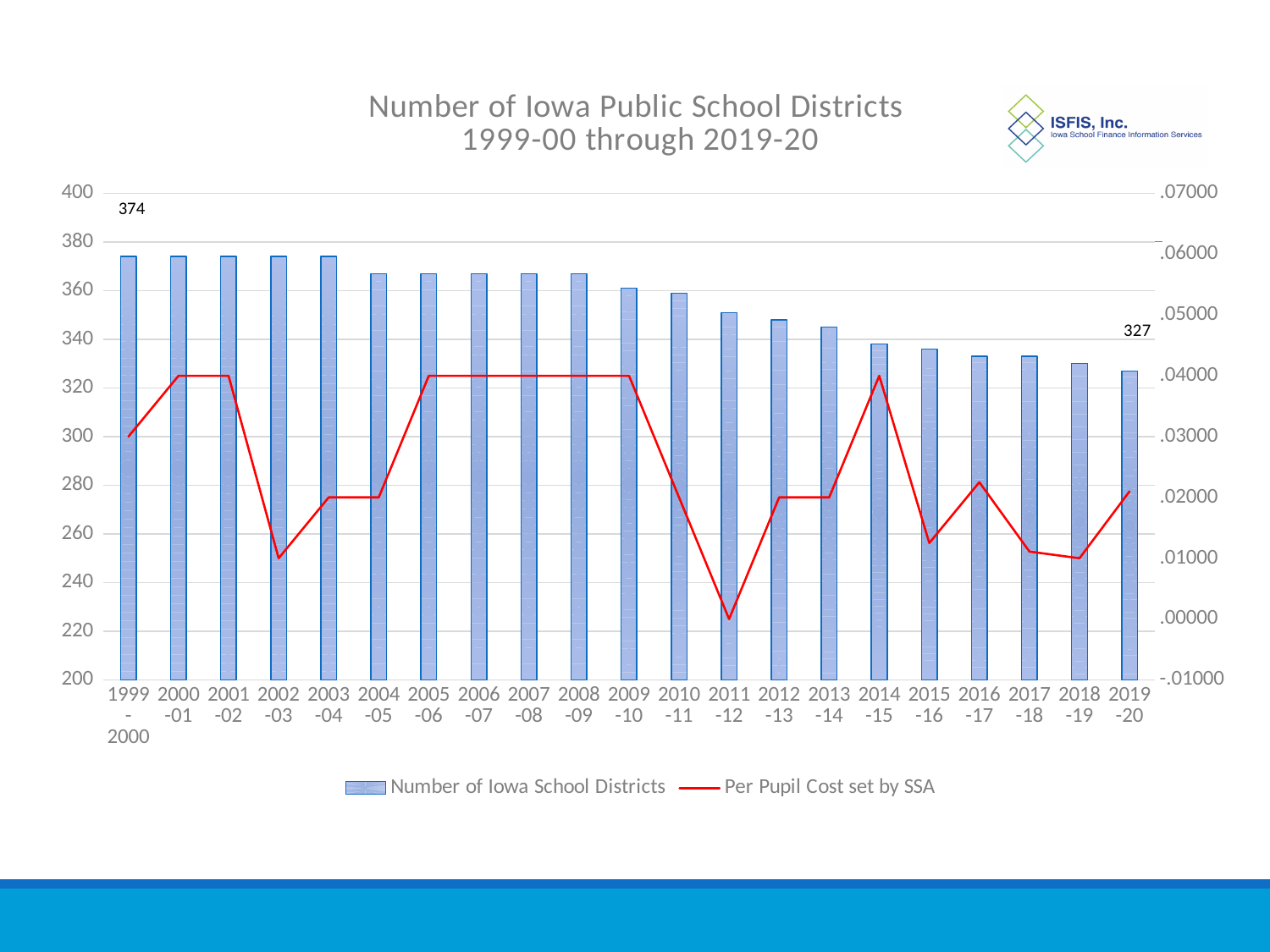
What series does the red line represent? Per Pupil Cost set by SSA What kind of chart is this? bar chart with a line In which school year is the Per Pupil Cost set by SSA line at its lowest point? 2011-12 Is the number of Iowa school districts for 2011-12 greater or less than 340? greater Do the bars for the number of Iowa school districts rise or fall from 1999-2000 to 2019-20? fall How many series does the legend list? 2 Which has more Iowa school districts, 2009-10 or 2013-14? 2009-10 What is the number of Iowa school districts shown for 1999-2000? 374 What is the number of Iowa school districts shown for 2019-20? 327 How many school years are shown along the x axis? 21 Is the number of Iowa school districts for 2004-05 greater or less than 380? less By how much did the number of Iowa school districts fall from 1999-2000 to 2019-20? 47